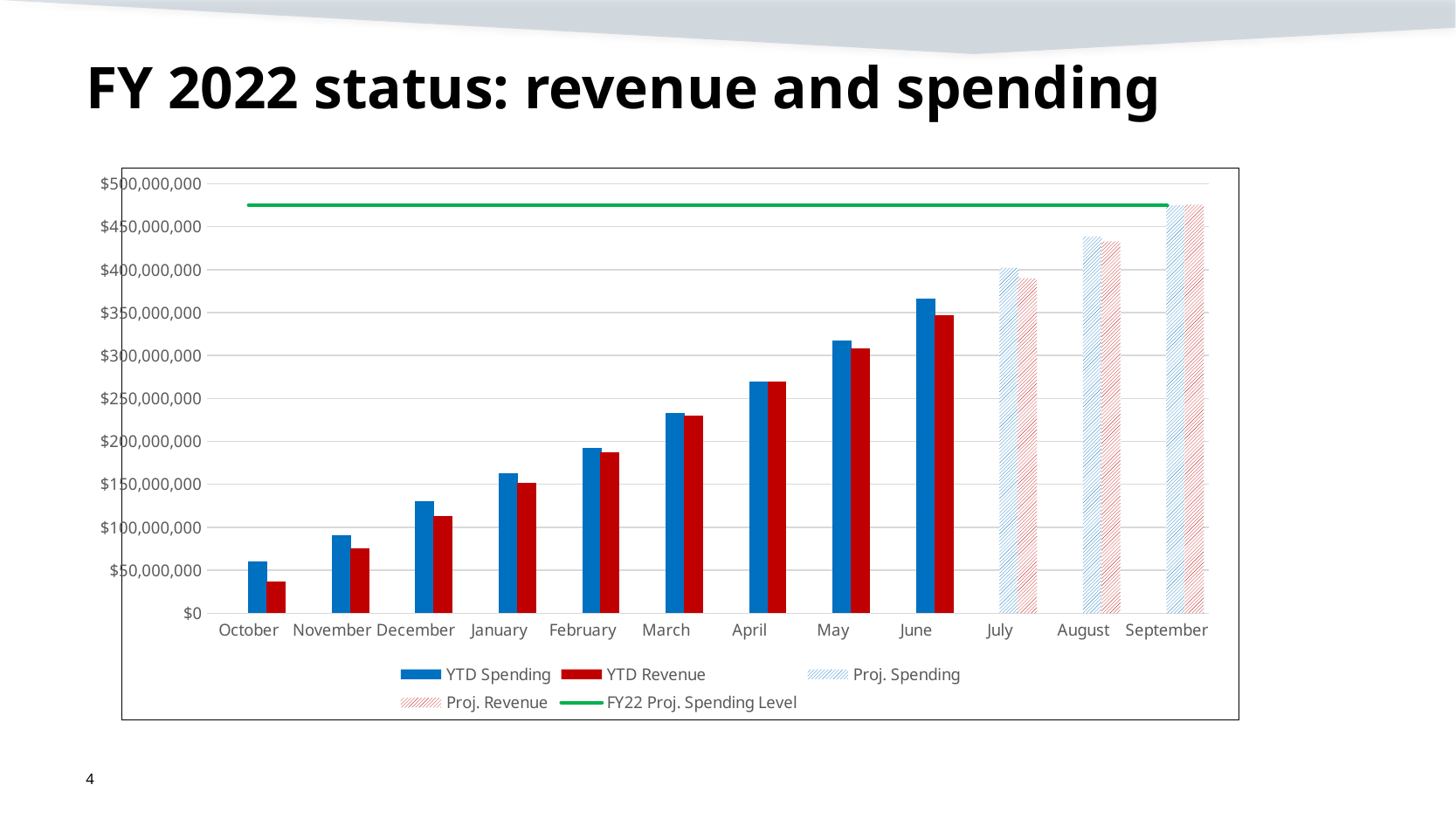
What does the green horizontal line represent according to the legend? FY22 Proj. Spending Level Is the YTD Revenue value for May greater or less than $350,000,000? less Is the Proj. Spending value for July greater or less than $450,000,000? less What kind of chart is shown on the slide? combination bar and line chart Is the YTD Spending value for June greater or less than $350,000,000? greater How many months are shown along the x axis? 12 Do the YTD Spending values rise or fall from October to June? rise How many series does the legend list? 5 Which month has the lowest YTD Revenue bar? October In October, which is larger, YTD Spending or YTD Revenue? YTD Spending Which month has the highest YTD Spending bar? June